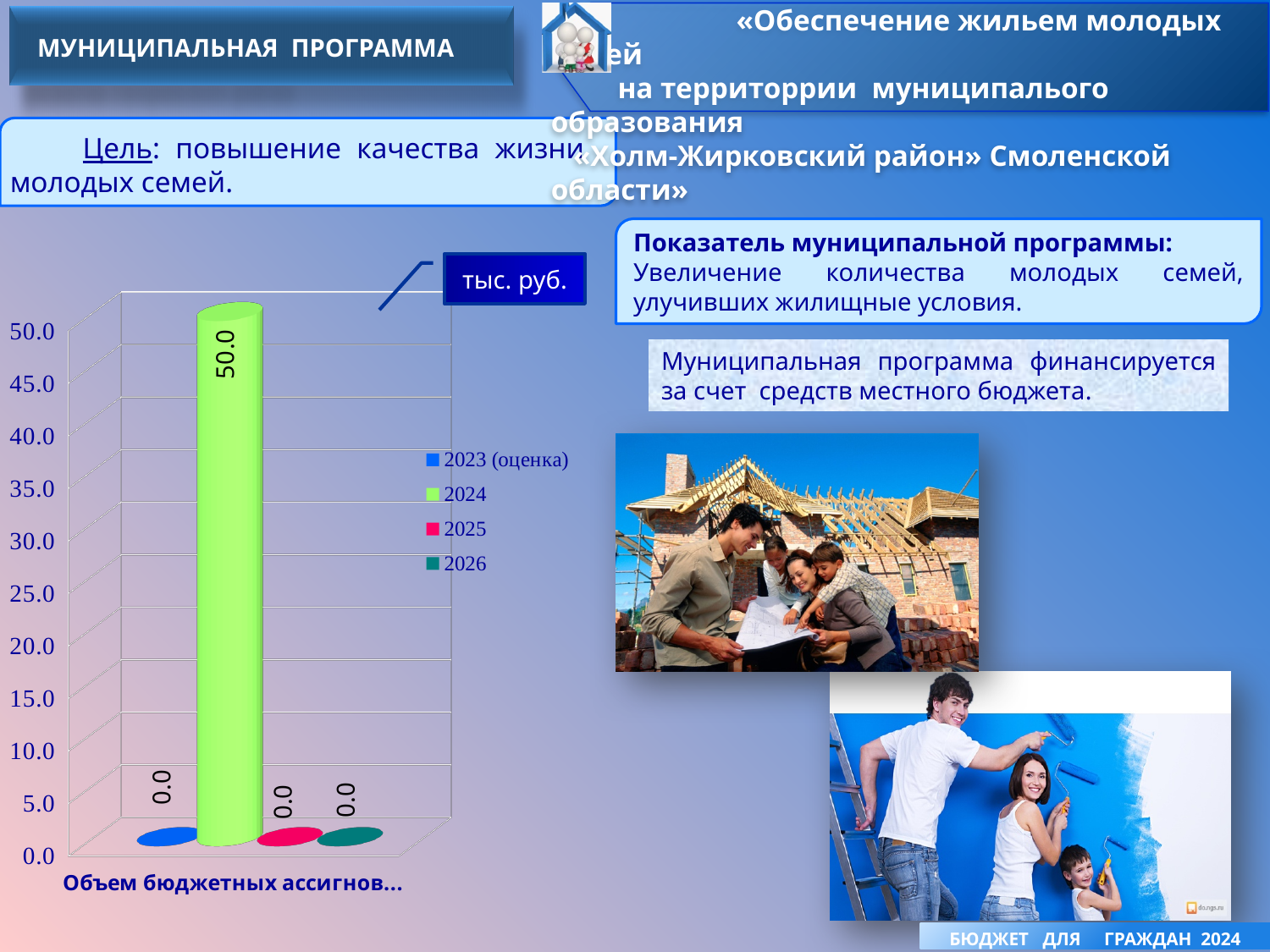
Which series has the highest value in the chart? 2024 What is the difference between the 2024 value and the 2025 value in the chart? 50.0 What is the value for the 2025 series in the chart? 0.0 What colour is the bar for the 2024 series in the chart? green How many series does the chart legend list? 4 Which is larger in the chart, the value for 2024 or the value for 2026? 2024 What is the value for the 2023 (оценка) series in the chart? 0.0 What is the value for the 2024 series in the chart? 50.0 What is the value for the 2026 series in the chart? 0.0 Is the value for 2024 greater or less than 45.0? greater What unit of measurement is indicated for the chart values? тыс. руб. What kind of chart is shown on the slide? bar chart